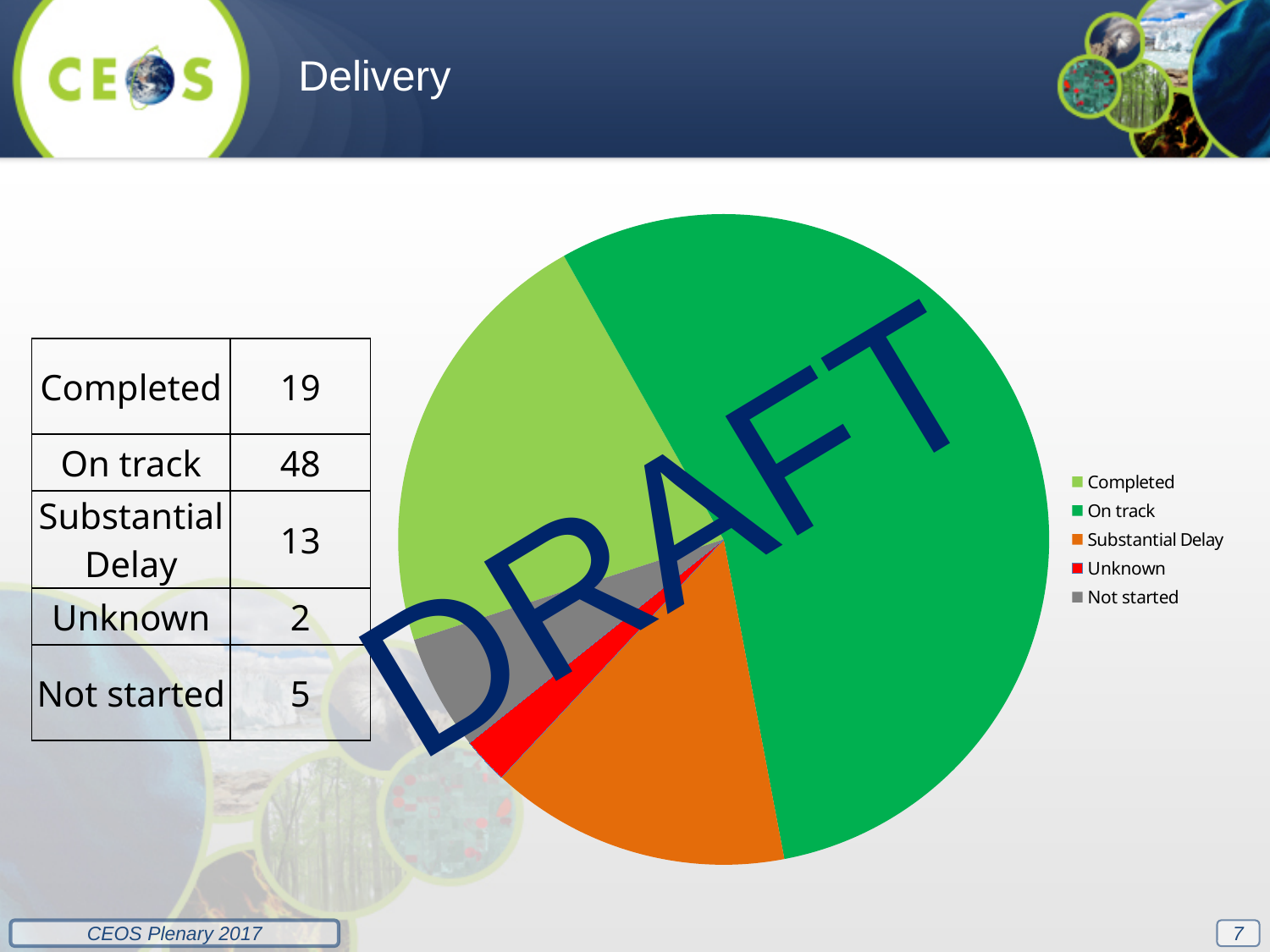
What is the difference between the On track and Completed values? 29 Which category has the largest slice of the pie? On track What type of chart is shown on the slide? pie chart What is the total of all the categories shown in the table? 87 What is the value for On track? 48 Which category has the smallest slice of the pie? Unknown What is the value for Completed? 19 How many categories does the pie chart's legend list? 5 What is the value for Unknown? 2 What is the value for Substantial Delay? 13 Which colour represents Substantial Delay in the pie chart? orange Which is larger, Not started or Unknown? Not started